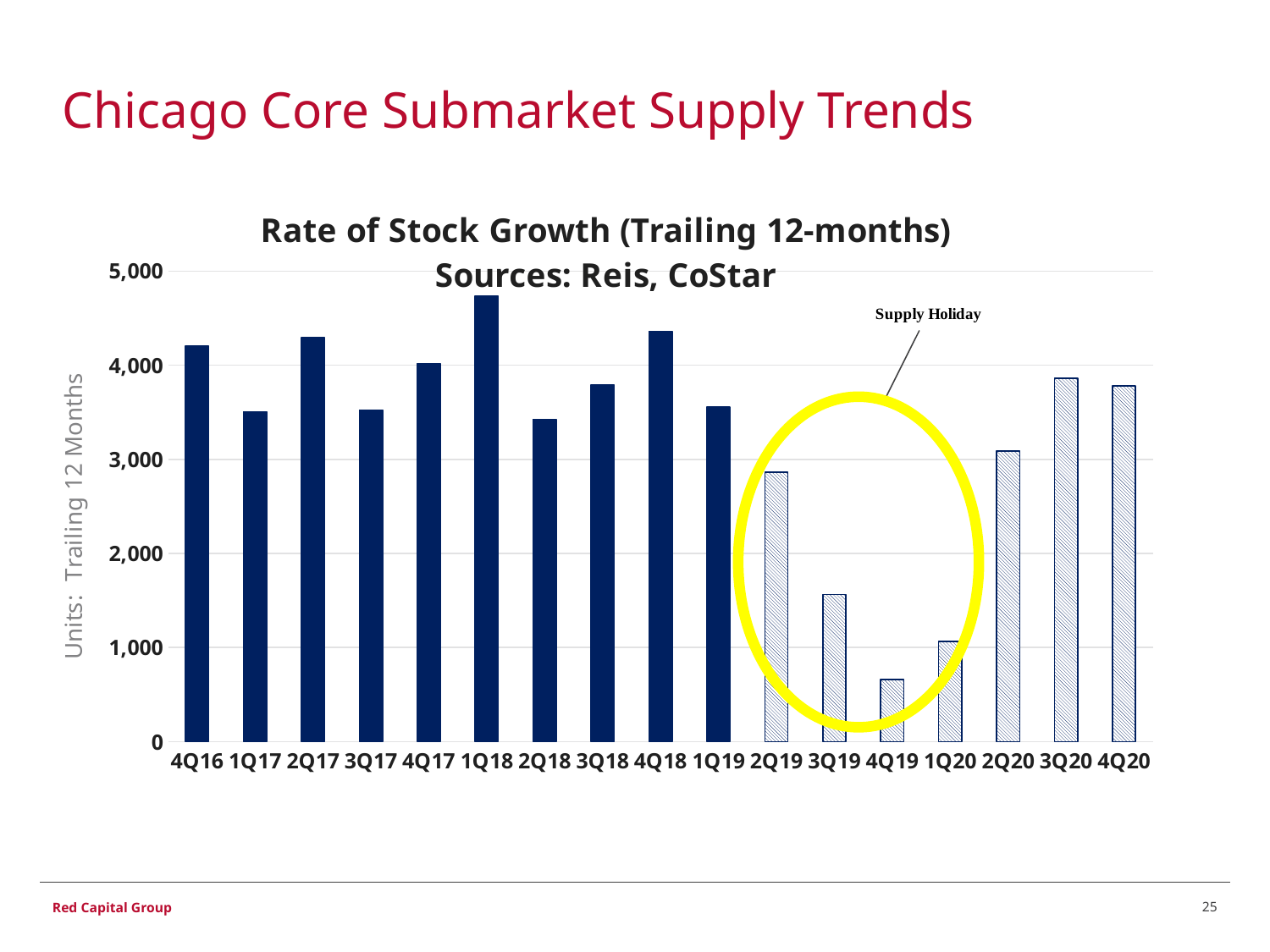
Is the value for 2Q19 greater or less than 3,000? less Which quarter has the lowest rate of stock growth? 4Q19 Is the value for 3Q20 greater or less than 4,000? less Which quarter has the highest rate of stock growth? 1Q18 What is the title of the chart? Rate of Stock Growth (Trailing 12-months) Sources: Reis, CoStar Which is larger, the value for 1Q18 or the value for 4Q18? 1Q18 What label is attached to the yellow circle on the chart? Supply Holiday Do the values rise or fall from 1Q19 to 4Q19? Fall Is the value for 4Q16 greater or less than 4,000? greater What kind of chart is shown on the slide? Bar chart How many quarters are plotted along the x axis? 17